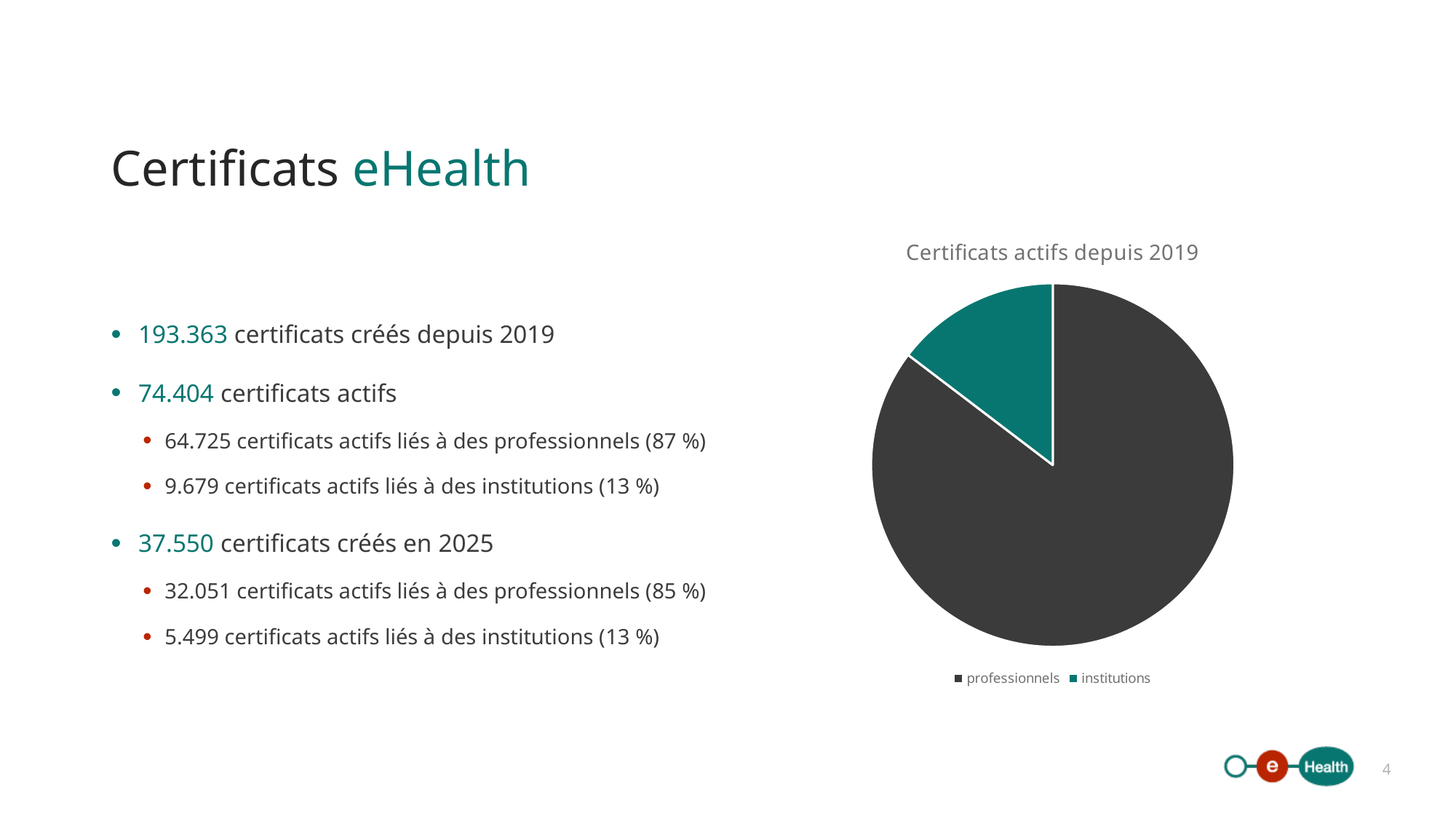
How many entries does the legend of the pie chart list? 2 Which category has the smallest slice in the pie chart? institutions How many active certificates are linked to professionnels, as shown on the slide? 64.725 How many slices does the pie chart have? 2 Which colour is used for the institutions slice in the pie chart? teal Which category has the largest slice in the pie chart? professionnels How many active certificates are linked to institutions, as shown on the slide? 9.679 What is the title of the pie chart? Certificats actifs depuis 2019 What kind of chart is shown on the slide? pie chart Which slice is larger in the pie chart, professionnels or institutions? professionnels